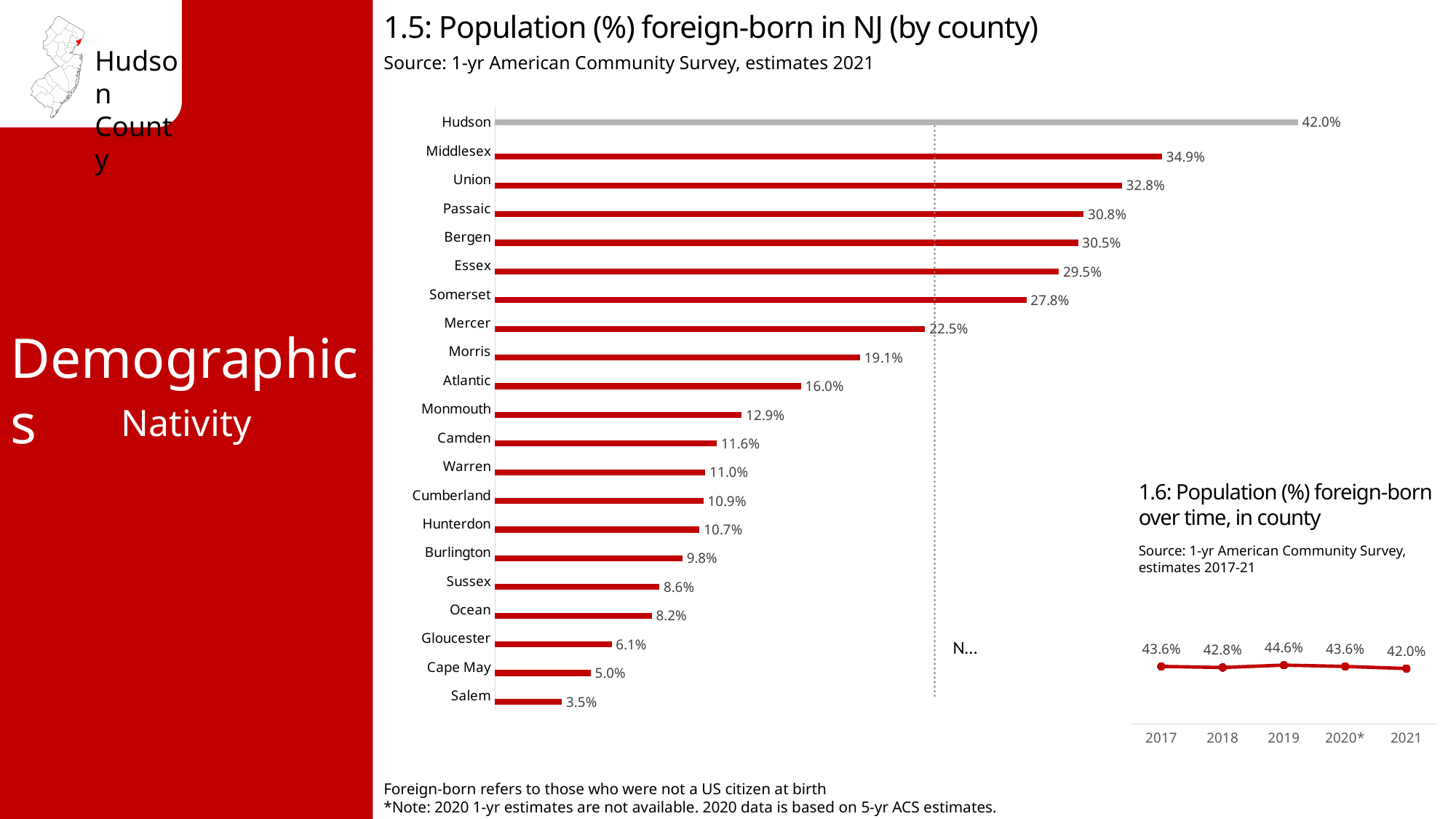
What kind of chart is '1.6: Population (%) foreign-born over time, in county'? Line chart In the chart '1.5: Population (%) foreign-born in NJ (by county)', which county has the highest value? Hudson In the chart '1.5: Population (%) foreign-born in NJ (by county)', what is the value for Hudson? 42.0% How many counties are shown in the chart '1.5: Population (%) foreign-born in NJ (by county)'? 21 In the chart '1.5: Population (%) foreign-born in NJ (by county)', which county has the lowest value? Salem In the chart '1.6: Population (%) foreign-born over time, in county', what is the difference between 2019 and 2021? 2.6% In the chart '1.5: Population (%) foreign-born in NJ (by county)', which is larger, Morris or Atlantic? Morris In the chart '1.5: Population (%) foreign-born in NJ (by county)', what is the value for Mercer? 22.5% In the chart '1.6: Population (%) foreign-born over time, in county', what is the value for 2019? 44.6% What kind of chart is '1.5: Population (%) foreign-born in NJ (by county)'? Bar chart In the chart '1.5: Population (%) foreign-born in NJ (by county)', what is the difference between Middlesex and Union? 2.1% In the chart '1.6: Population (%) foreign-born over time, in county', which year has the lowest value? 2021